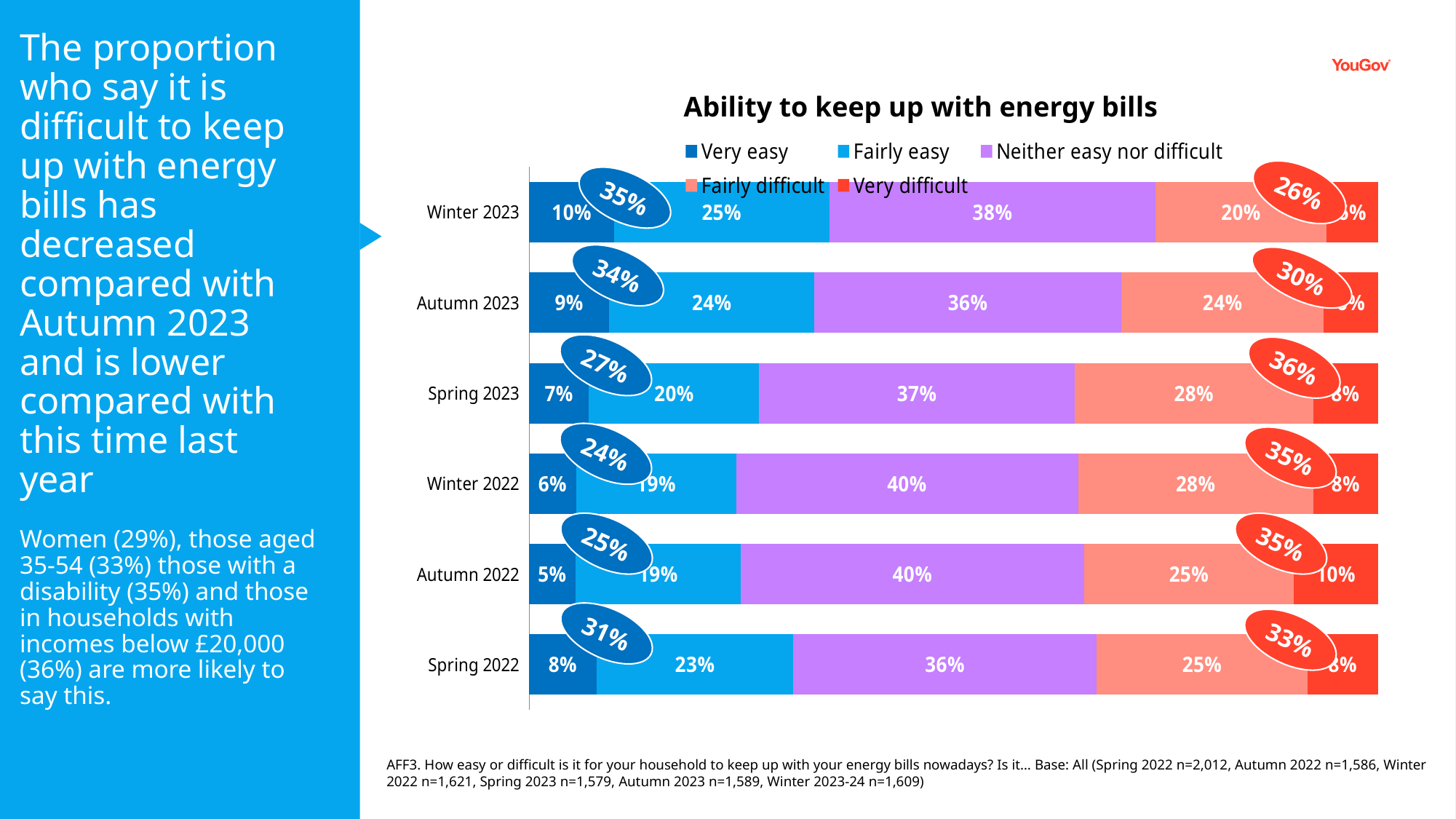
What is the 'Neither easy nor difficult' value for Winter 2023? 38% What is the title of the chart? Ability to keep up with energy bills What type of chart is shown on the slide? Stacked bar chart What is the difference between the 'Fairly easy' values for Winter 2023 and Winter 2022? 6 percentage points How many series does the legend list? 5 Which period has the lowest 'Very easy' value? Autumn 2022 Which is larger: the 'Fairly difficult' value for Autumn 2023 or for Winter 2023? Autumn 2023 Which period has the highest 'Very easy' value? Winter 2023 How many time periods (categories) are shown on the chart? 6 What is the combined 'Very easy' and 'Fairly easy' total shown in the oval for Spring 2022? 31% What is the 'Very difficult' value for Autumn 2022? 10% What is the 'Fairly difficult' value for Spring 2023? 28%